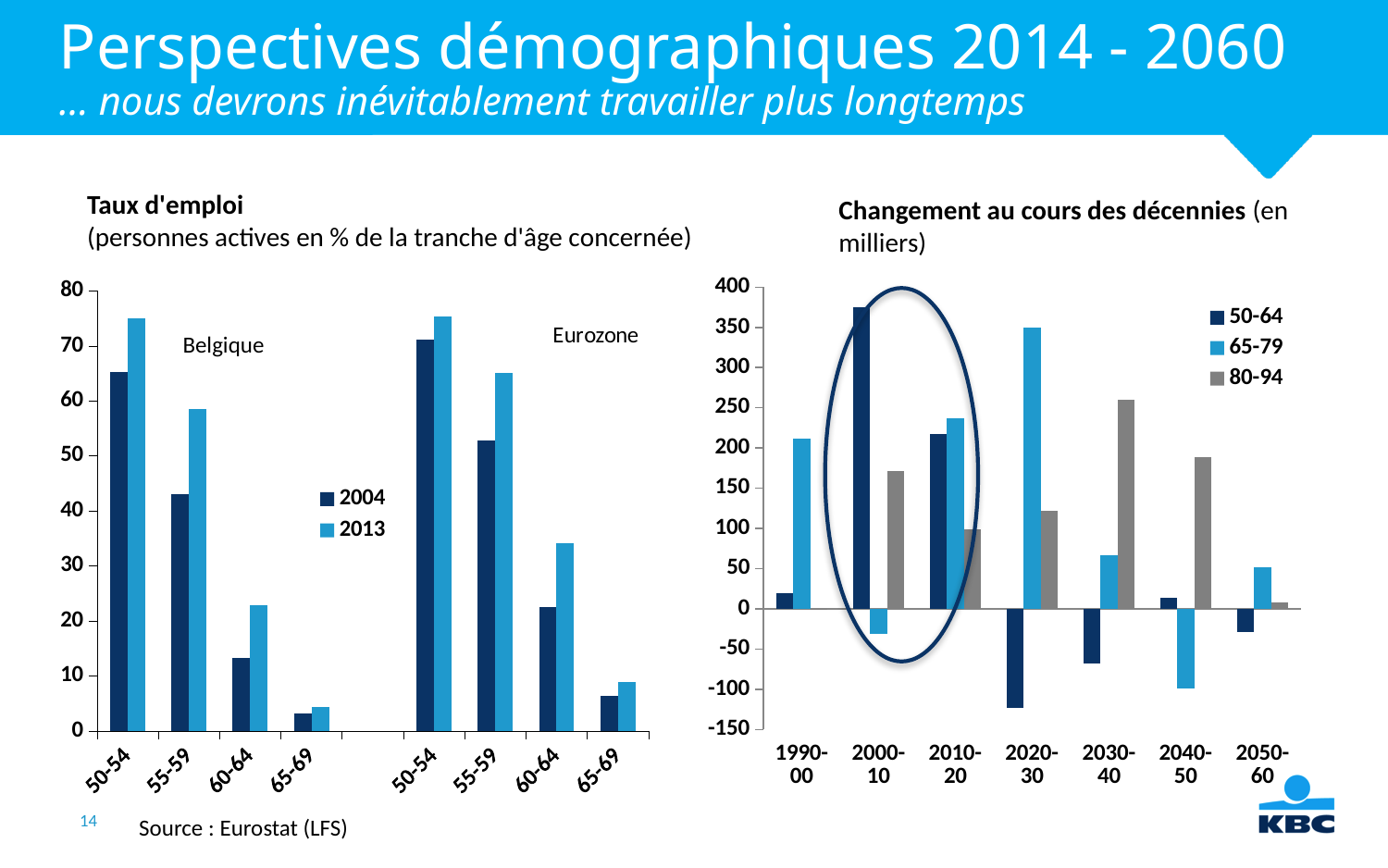
In the left chart "Taux d'emploi", is the 2013 value for the Belgique 50-54 group greater or less than 70? greater In the right chart "Changement au cours des décennies", which decade has the highest value for the 80-94 series? 2030-40 In the right chart "Changement au cours des décennies", which decade has the lowest value for the 50-64 series? 2020-30 In the right chart "Changement au cours des décennies", how many decade categories are shown on the x axis? 7 In the right chart "Changement au cours des décennies", which decade has the highest value for the 50-64 series? 2000-10 In the left chart "Taux d'emploi", do the 2013 values for Belgique rise or fall as the age groups go from 50-54 to 65-69? fall What kind of chart is the left chart titled "Taux d'emploi"? bar chart In the right chart "Changement au cours des décennies", is the 65-79 value for 2020-30 greater or less than 300? greater In the left chart "Taux d'emploi", how many series does the legend list? 2 In the left chart "Taux d'emploi", is the 2004 value for the Belgique 55-59 group greater or less than 50? less In the left chart "Taux d'emploi", for the Belgique 60-64 group, which series is larger, 2004 or 2013? 2013 In the right chart "Changement au cours des décennies", how many series does the legend list? 3